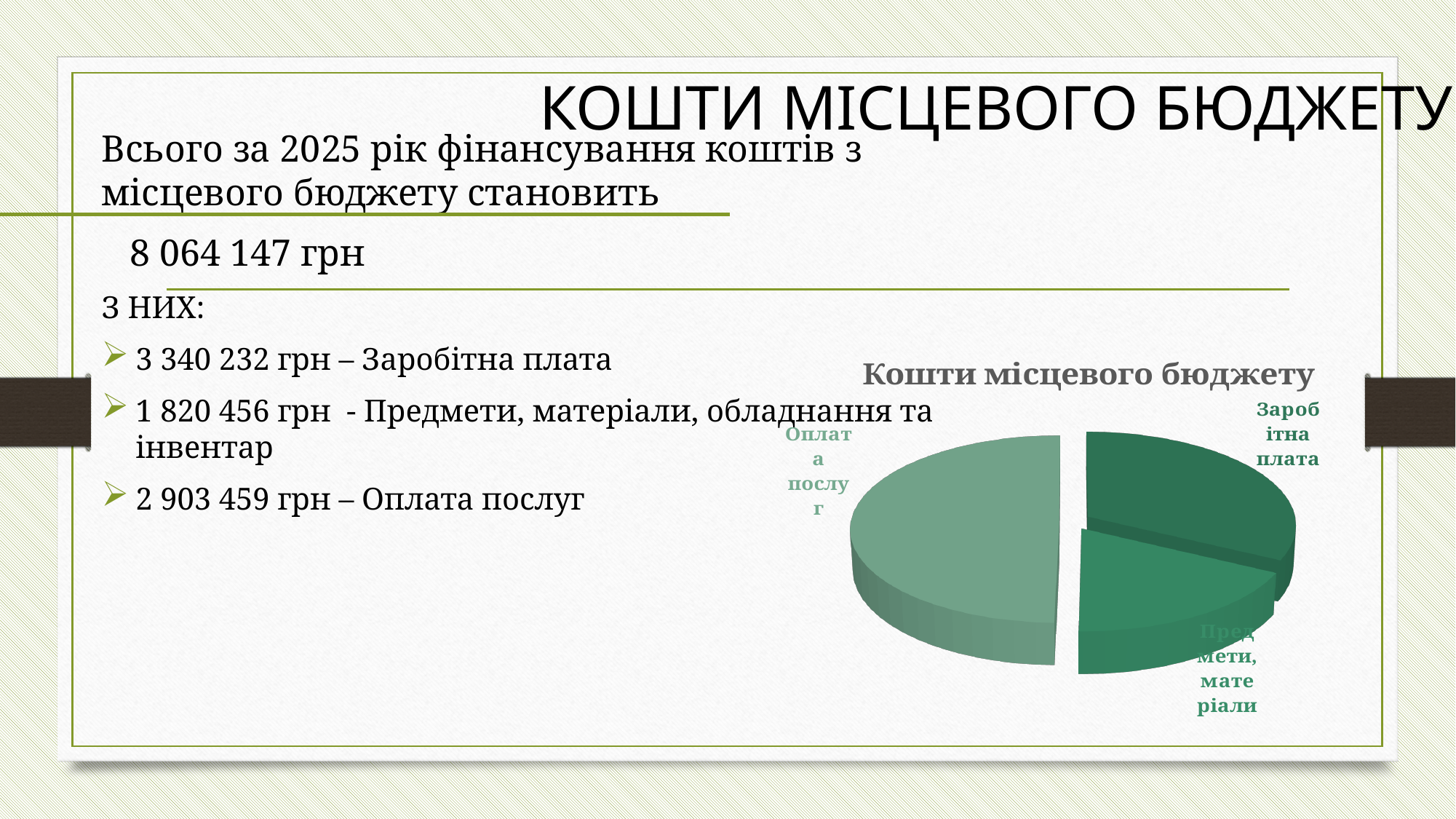
According to the slide, what is the amount for Предмети, матеріали, обладнання та інвентар? 1 820 456 грн What is the title of the chart? Кошти місцевого бюджету Which category has the smallest amount in the pie chart? Предмети, матеріали What is the total of all three categories shown on the slide? 8 064 147 грн What kind of chart is shown on the slide? Pie chart What is the difference between the amounts for Оплата послуг and Предмети, матеріали, обладнання та інвентар? 1 083 003 грн According to the slide, what is the amount for Оплата послуг? 2 903 459 грн How many slices does the pie chart have? 3 According to the slide, what is the amount for Заробітна плата? 3 340 232 грн Which is larger: the amount for Оплата послуг or for Предмети, матеріали, обладнання та інвентар? Оплата послуг What is the difference between the amounts for Заробітна плата and Предмети, матеріали, обладнання та інвентар? 1 519 776 грн